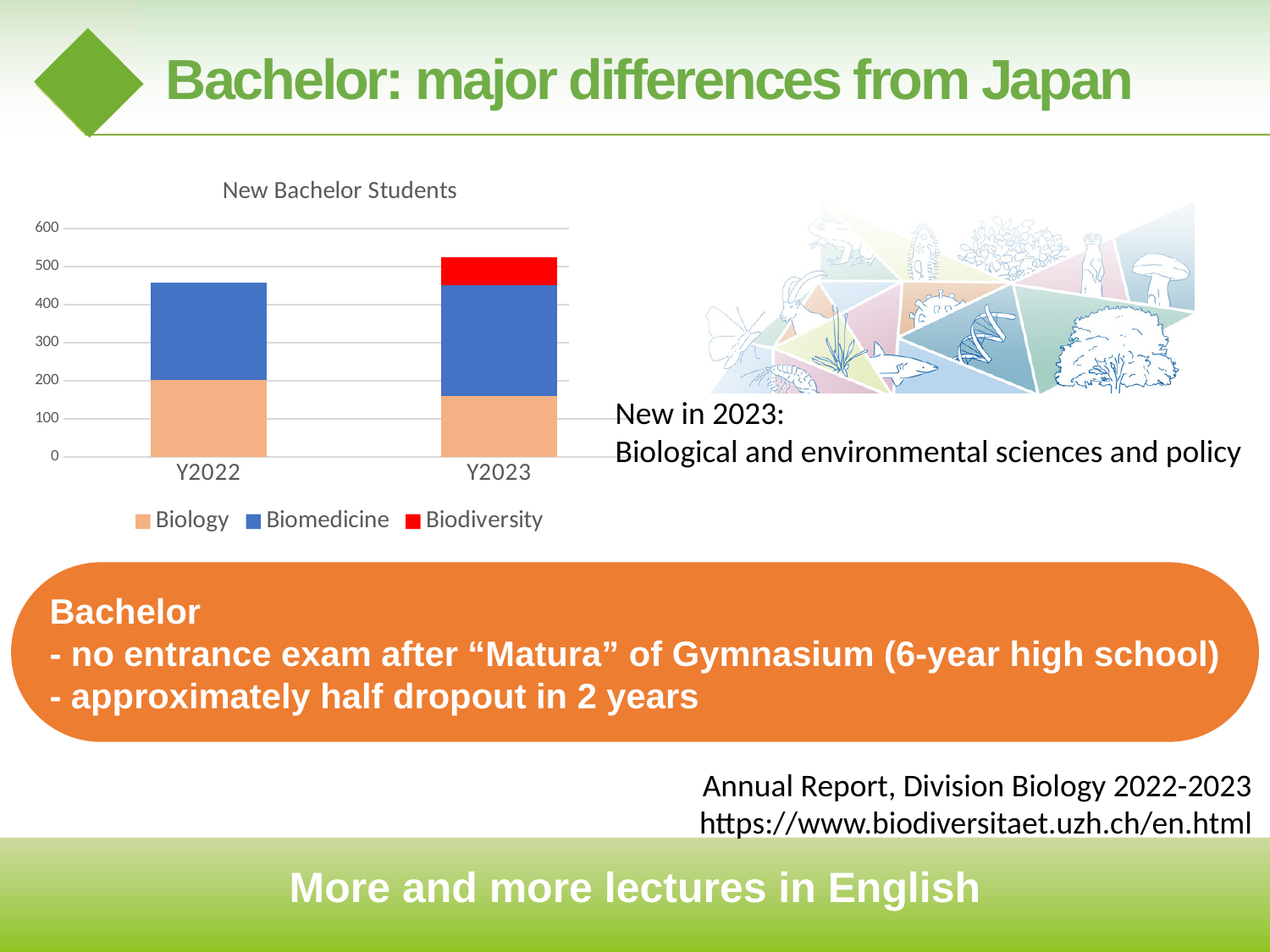
In which year does the Biodiversity series first appear in the chart? Y2023 Which year has the taller total bar, Y2022 or Y2023? Y2023 Is the Biology value for Y2022 greater or less than 100? greater How many categories (years) are shown on the x axis of the chart? 2 Which series is shown in red in the chart? Biodiversity Which year has the larger Biology segment, Y2022 or Y2023? Y2022 What kind of chart is shown on the slide? stacked bar chart Is the Biology value for Y2023 greater or less than 200? less How many series does the chart legend list? 3 Is the total bar height for Y2022 greater or less than 500? less What is the title of the chart? New Bachelor Students